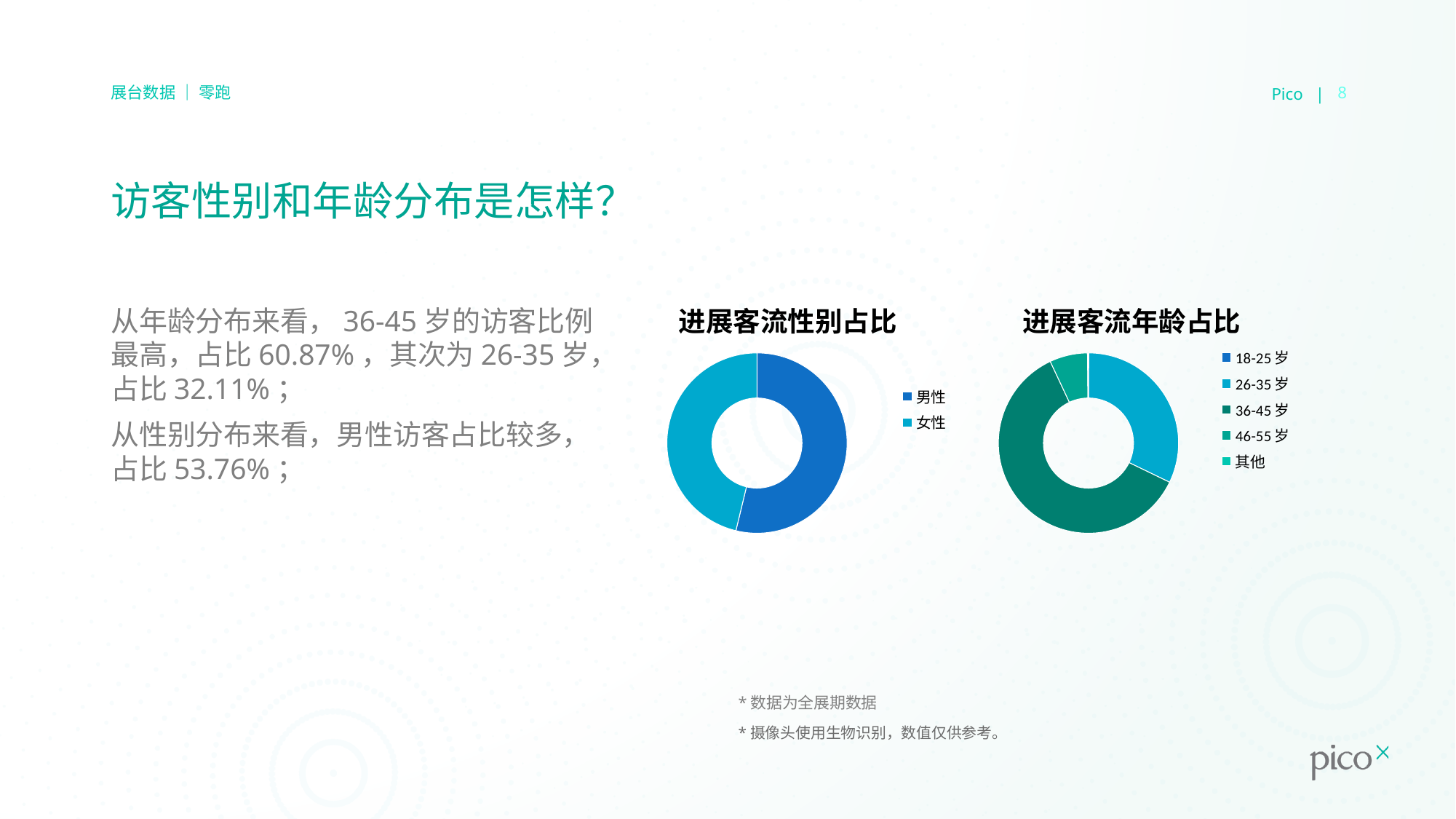
What is the title of the chart on the left? 进展客流性别占比 How many categories does the legend of the 进展客流年龄占比 chart list? 5 How many entries does the legend of the 进展客流性别占比 chart list? 2 In the 进展客流年龄占比 chart, which is larger, 26-35 岁 or 46-55 岁? 26-35 岁 In the 进展客流性别占比 chart, which is larger, 男性 or 女性? 男性 In the 进展客流年龄占比 chart, what is the share for 26-35 岁? 32.11% In the 进展客流年龄占比 chart, what is the difference between the shares of 36-45 岁 and 26-35 岁? 28.76% In the 进展客流年龄占比 chart, which age group has the largest share? 36-45 岁 What kind of chart is the 进展客流性别占比 chart? doughnut chart In the 进展客流性别占比 chart, what is the share for 男性? 53.76% In the 进展客流年龄占比 chart, what is the share for 36-45 岁? 60.87% In the 进展客流性别占比 chart, which category has the larger share? 男性